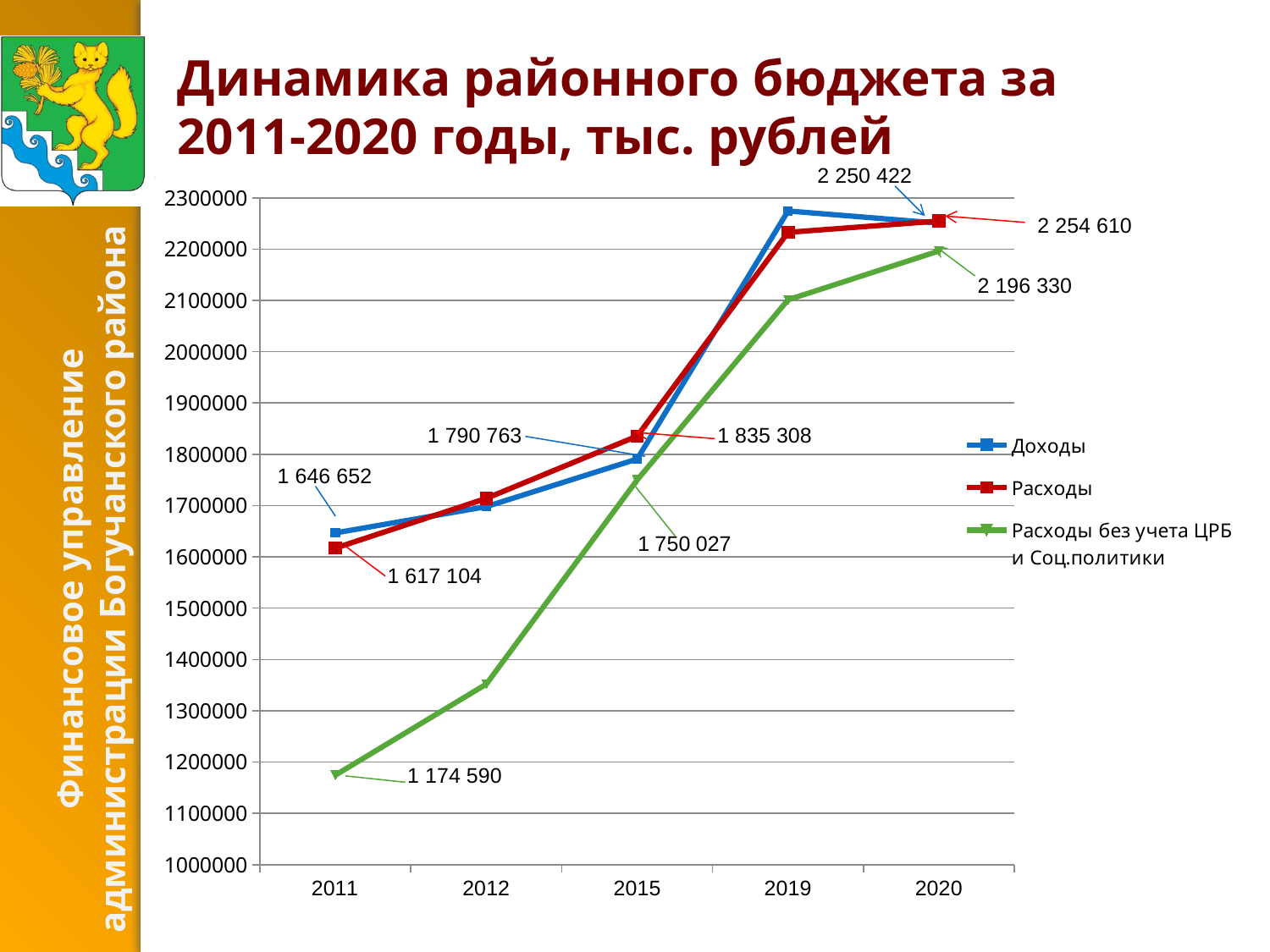
What is the value of Расходы in 2020? 2 254 610 What is the value of Расходы без учета ЦРБ и Соц.политики in 2020? 2 196 330 By how much do Расходы exceed Доходы in 2015? 44 545 Is the value of Доходы in 2019 greater or less than 2200000? greater Is the value of Расходы без учета ЦРБ и Соц.политики in 2012 greater or less than 1400000? less In 2015, which is larger: Доходы or Расходы? Расходы How many years are shown on the x axis? 5 What is the value of Доходы in 2011? 1 646 652 How many series does the legend list? 3 What is the value of Расходы in 2015? 1 835 308 What kind of chart is shown on the slide? line chart What is the difference between Доходы and Расходы in 2011? 29 548